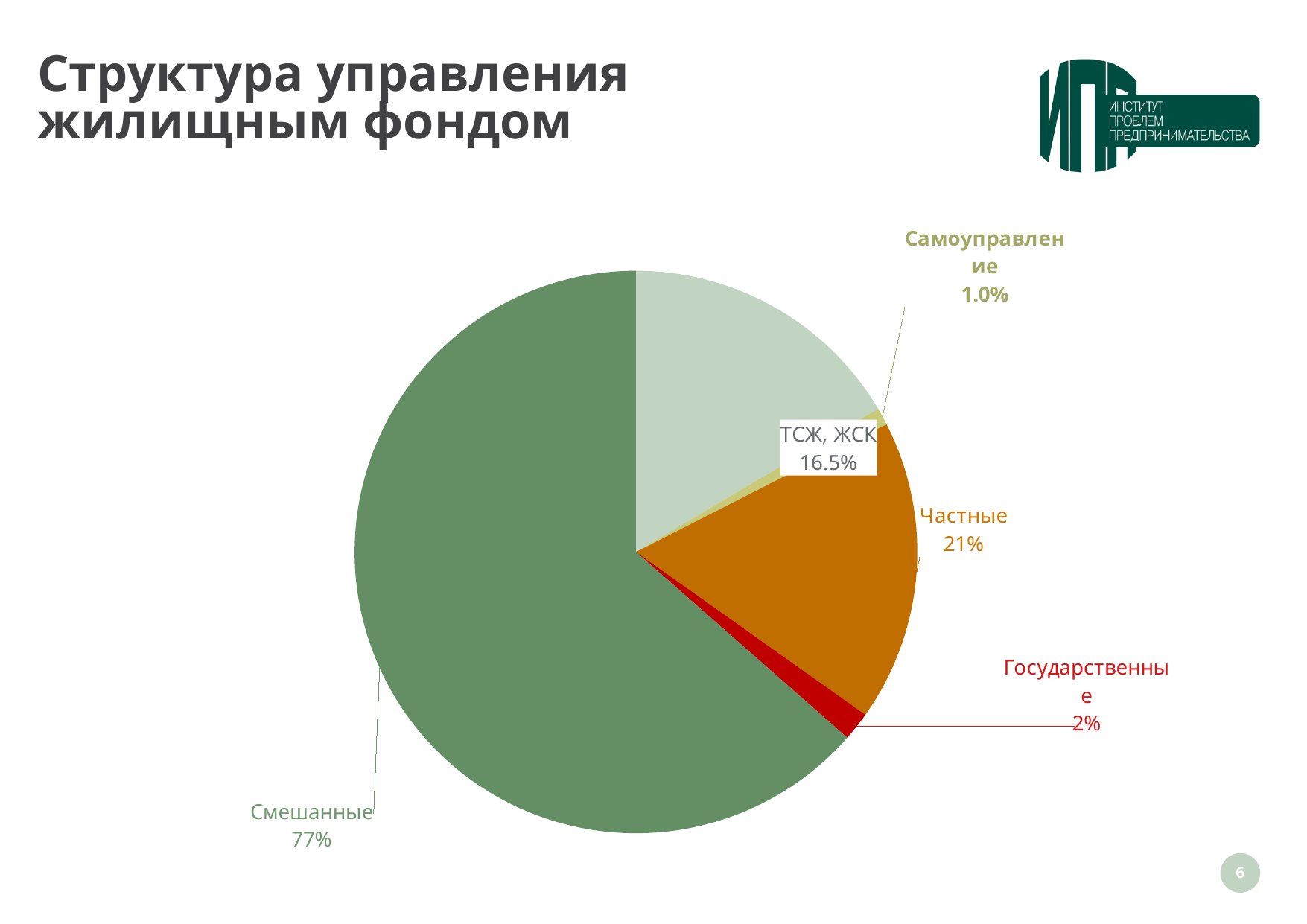
Which slice of the pie is the largest? Смешанные What share is shown for the Государственные slice? 2% How many slices does the pie chart have? 5 What is the title of the slide containing the pie chart? Структура управления жилищным фондом What share is shown for the Смешанные slice? 77% What kind of chart is shown on the slide? pie chart What share is shown for the Частные slice? 21% Which is larger, the Частные slice or the ТСЖ, ЖСК slice? Частные What share is shown for the Самоуправление slice? 1.0% What share is shown for the ТСЖ, ЖСК slice? 16.5% Which slice of the pie is the smallest? Самоуправление What is the difference in percentage points between the Смешанные slice and the Частные slice? 56